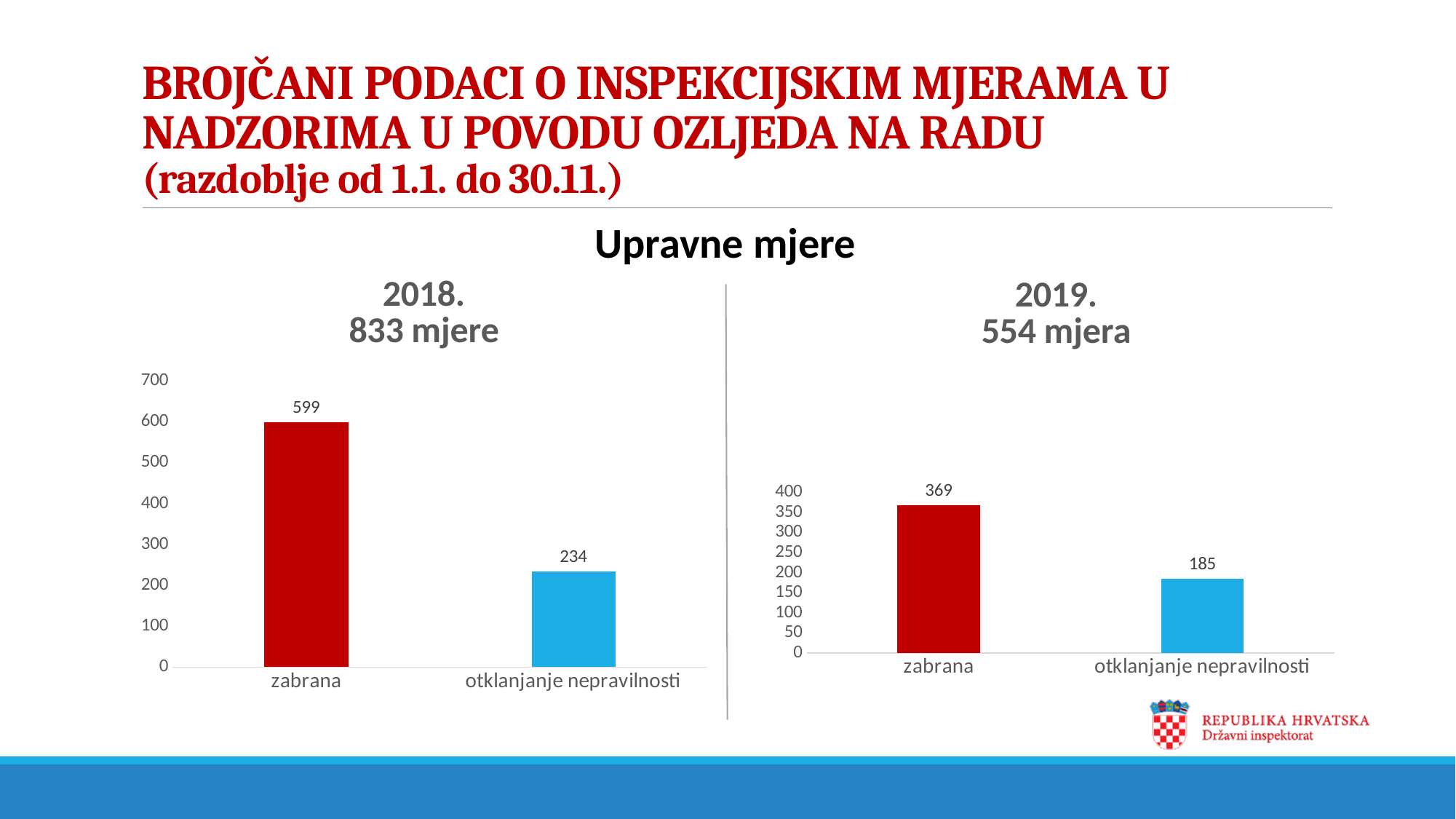
In the 2018. chart, what is the value for otklanjanje nepravilnosti? 234 Is the value for zabrana larger in the 2018. chart or in the 2019. chart? 2018. In the 2019. chart, which category has the lowest value? otklanjanje nepravilnosti In the 2018. chart, which category has the highest value? zabrana In the 2019. chart, what is the value for otklanjanje nepravilnosti? 185 In the 2018. chart, what is the value for zabrana? 599 What kind of chart is the 2018. chart? bar chart How many categories are shown in the 2019. chart? 2 In the 2019. chart, what is the difference between zabrana and otklanjanje nepravilnosti? 184 What is the title shown above both charts? Upravne mjere In the 2019. chart, what is the value for zabrana? 369 In the 2018. chart, what is the difference between zabrana and otklanjanje nepravilnosti? 365